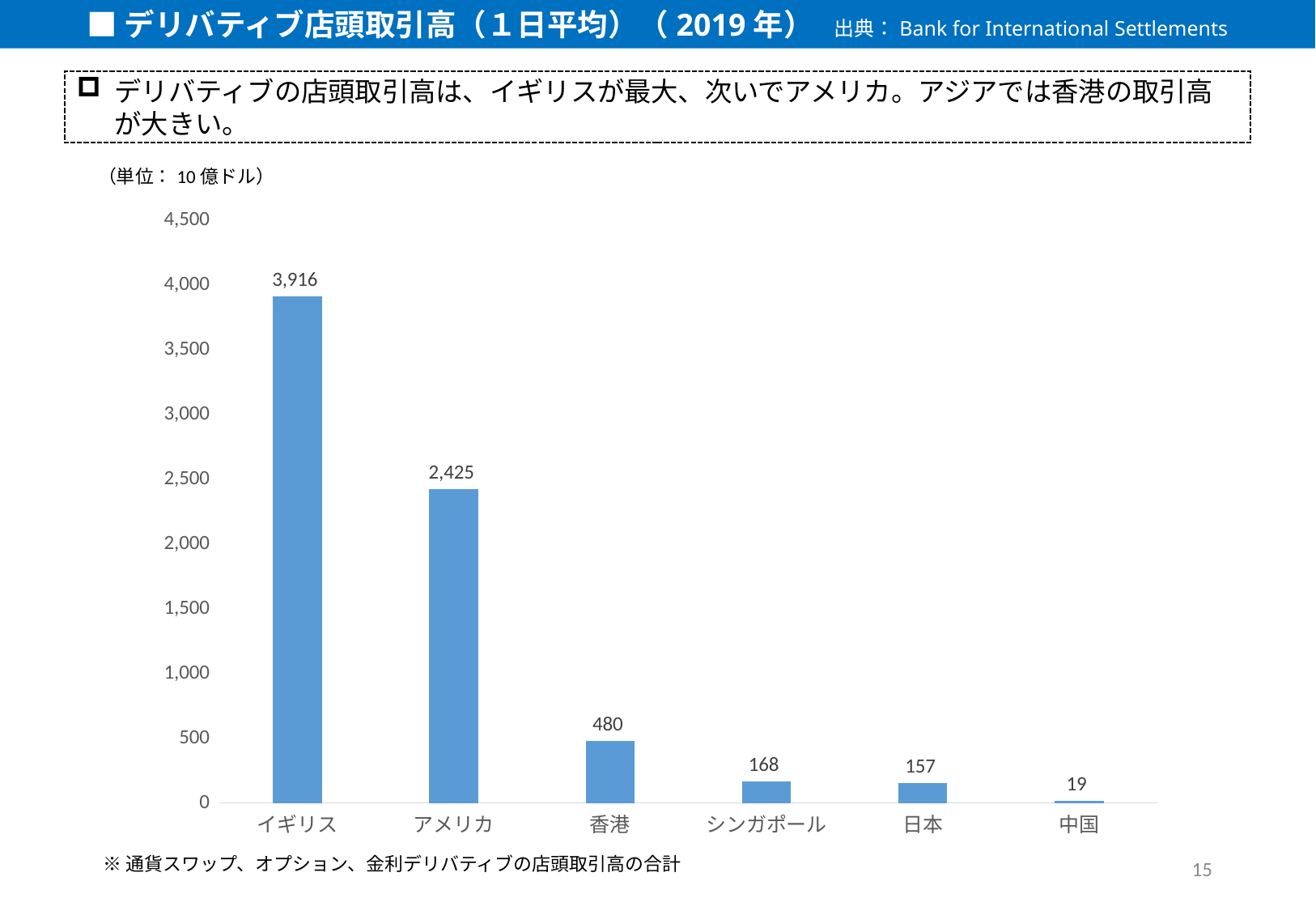
What is the value for イギリス (UK)? 3,916 How many categories are shown on the x axis? 6 What is the difference between the values for イギリス and アメリカ? 1,491 Which category has the lowest value? 中国 What is the value for 中国 (China)? 19 Which category has the highest value? イギリス Which is larger, the value for 香港 or the value for シンガポール? 香港 What is the difference between the values for シンガポール and 日本? 11 What kind of chart is shown on the slide? bar chart What is the value for 香港 (Hong Kong)? 480 What is the value for アメリカ (USA)? 2,425 What unit is stated for the values in the chart? 10億ドル